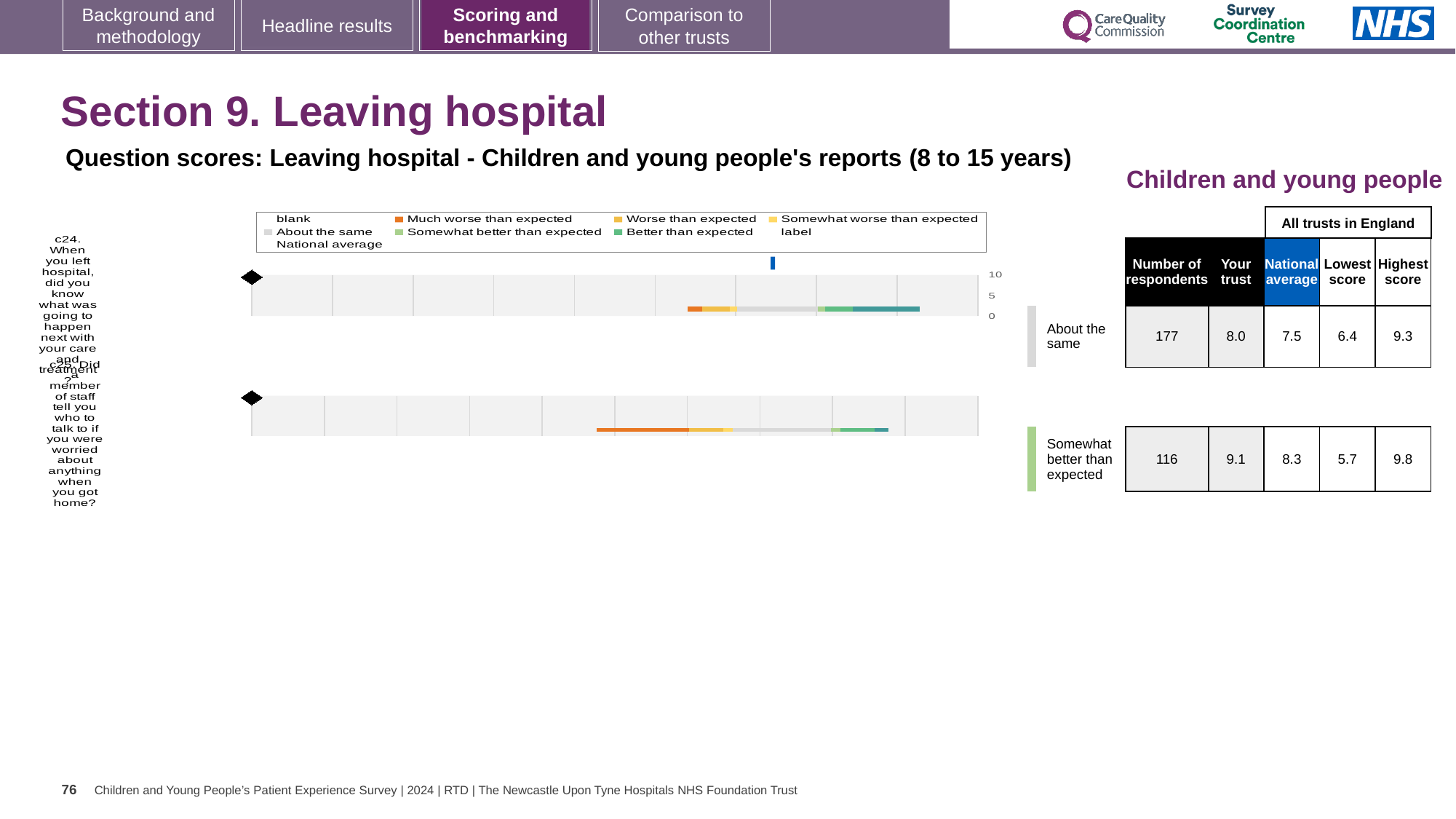
How many respondents answered question c25 (did a member of staff tell you who to talk to if you were worried when you got home)? 116 How many survey questions (c24 and c25) have a benchmark bar chart on this slide? 2 For question c24, which is higher: the 'Your trust' score or the national average? Your trust What is the difference between the highest score (9.3) and the lowest score (6.4) for question c24? 2.9 What is the 'Your trust' score for question c24 (did you know what was going to happen next with your care and treatment)? 8.0 What is the 'Your trust' score for question c25? 9.1 What is the national average score for question c24? 7.5 What colour does the legend use for 'Much worse than expected'? orange What is the difference between the 'Your trust' score (9.1) and the national average (8.3) for question c25? 0.8 What kind of chart is used to show the question scores on this slide? bar chart Which benchmark category is the trust's result for question c25 placed in? Somewhat better than expected What is the highest score among all trusts in England for question c25? 9.8